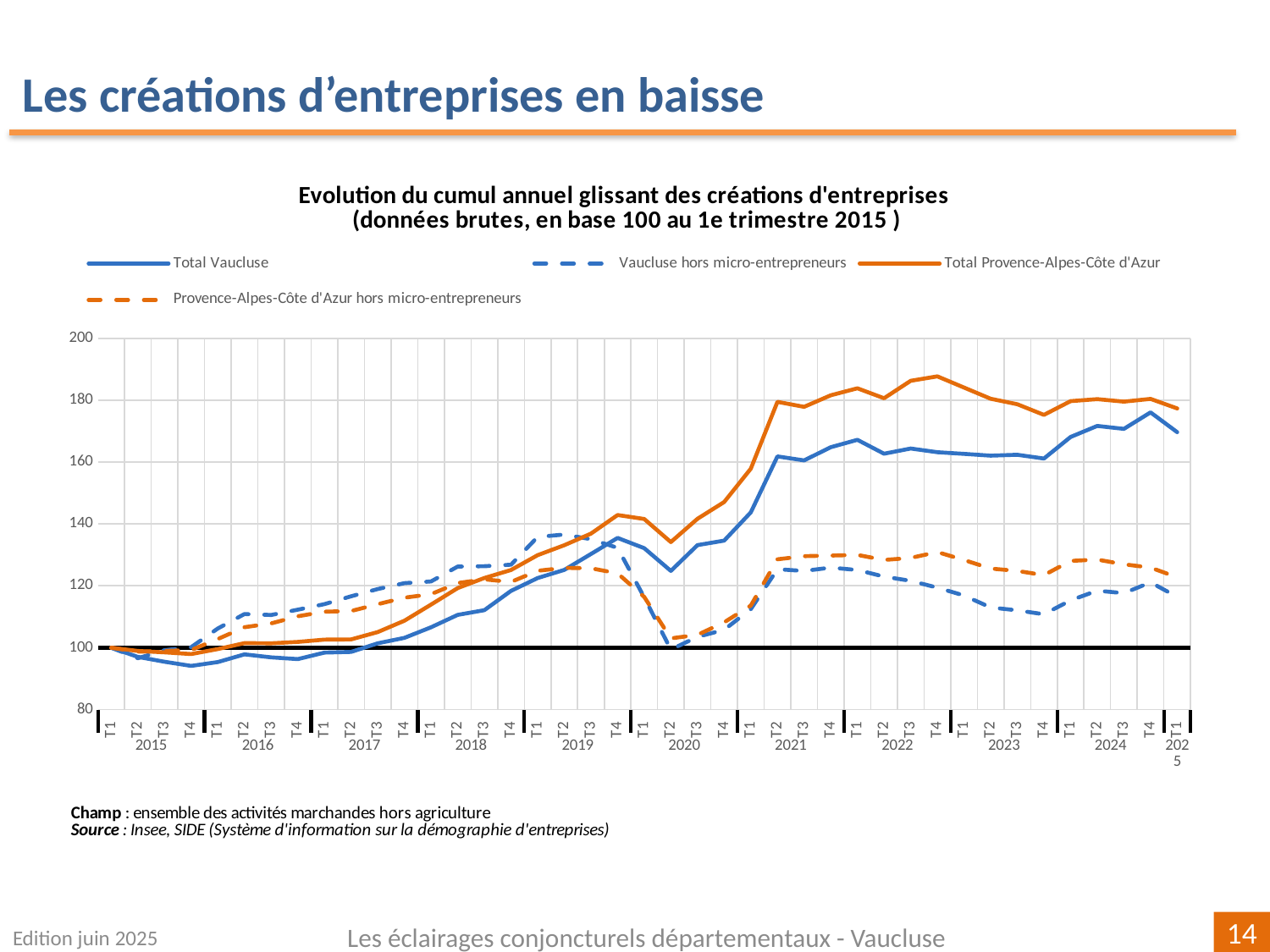
What is the value of all series at T1 2015, the base quarter? 100 Is the value for Vaucluse hors micro-entrepreneurs at T2 2020 greater or less than 120? less Is the value for Total Vaucluse at T4 2015 greater or less than 100? less Is the value for Provence-Alpes-Côte d'Azur hors micro-entrepreneurs at T1 2025 greater or less than 140? less How many series does the legend list? 4 What is the title of the chart? Evolution du cumul annuel glissant des créations d'entreprises (données brutes, en base 100 au 1e trimestre 2015 ) What kind of chart is shown on the slide? line chart Which series has the highest value at T4 2022? Total Provence-Alpes-Côte d'Azur Does the Total Provence-Alpes-Côte d'Azur series rise or fall overall from T1 2015 to T1 2025? rise At T1 2025, which is higher: Total Provence-Alpes-Côte d'Azur or Total Vaucluse? Total Provence-Alpes-Côte d'Azur